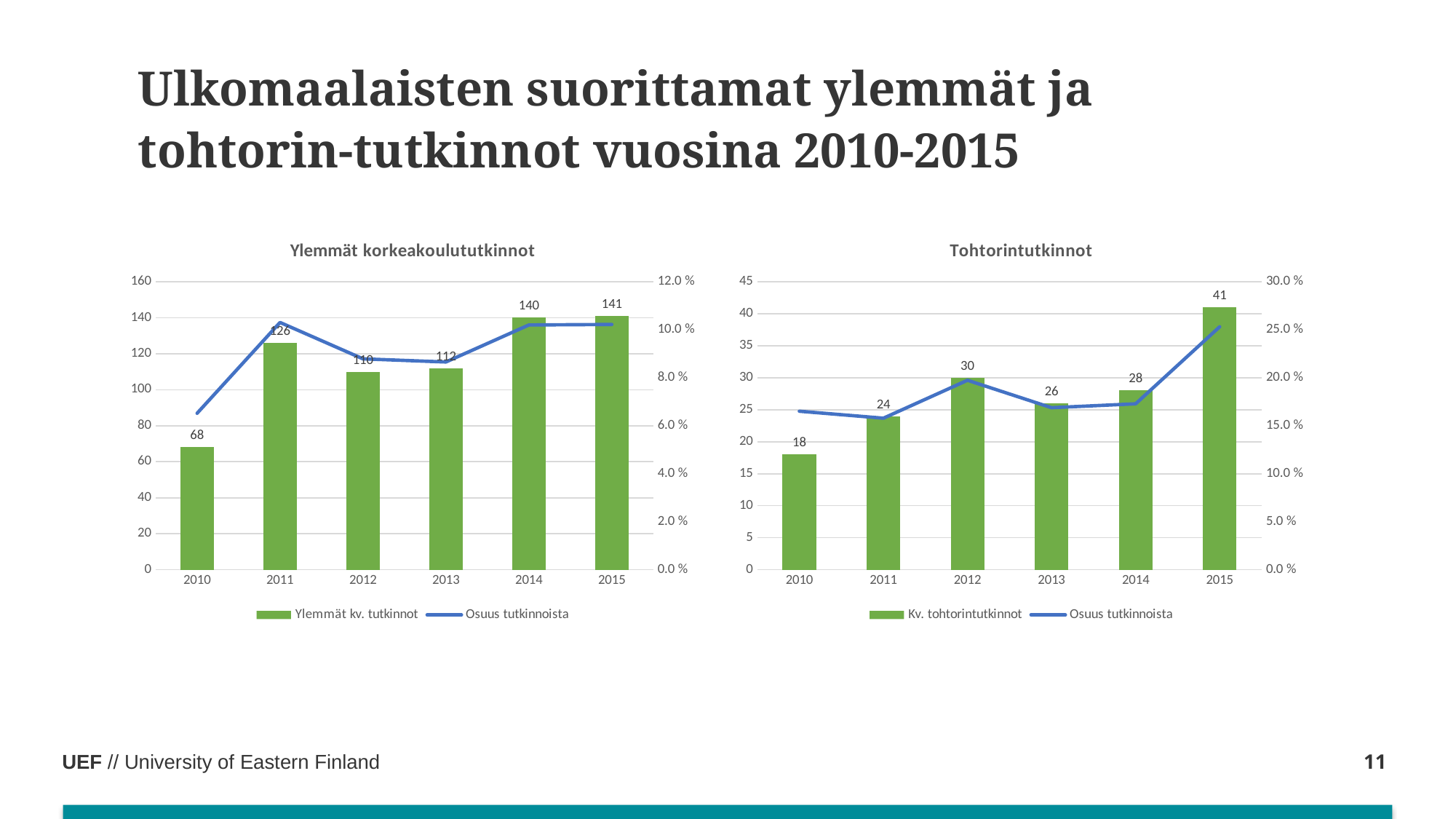
In the 'Ylemmät korkeakoulututkinnot' chart, which year has the highest number of Ylemmät kv. tutkinnot? 2015 In the 'Tohtorintutkinnot' chart, is the Kv. tohtorintutkinnot value larger for 2012 or 2014? 2012 In the 'Ylemmät korkeakoulututkinnot' chart, what is the difference between the Ylemmät kv. tutkinnot values for 2011 and 2012? 16 In the 'Ylemmät korkeakoulututkinnot' chart, is the Osuus tutkinnoista value for 2010 greater or less than 8.0 %? less How many years are shown on the x axis of the 'Tohtorintutkinnot' chart? 6 In the 'Tohtorintutkinnot' chart, what is the value of Kv. tohtorintutkinnot for 2013? 26 In the 'Ylemmät korkeakoulututkinnot' chart, which year has the lowest number of Ylemmät kv. tutkinnot? 2010 In the 'Tohtorintutkinnot' chart, what is the difference between the Kv. tohtorintutkinnot values for 2015 and 2010? 23 In the 'Tohtorintutkinnot' chart, is the Osuus tutkinnoista value for 2015 greater or less than 20.0 %? greater In the 'Ylemmät korkeakoulututkinnot' chart, how many series does the legend list? 2 In the 'Ylemmät korkeakoulututkinnot' chart, what is the value of Ylemmät kv. tutkinnot for 2010? 68 In the 'Tohtorintutkinnot' chart, which year has the highest number of Kv. tohtorintutkinnot? 2015